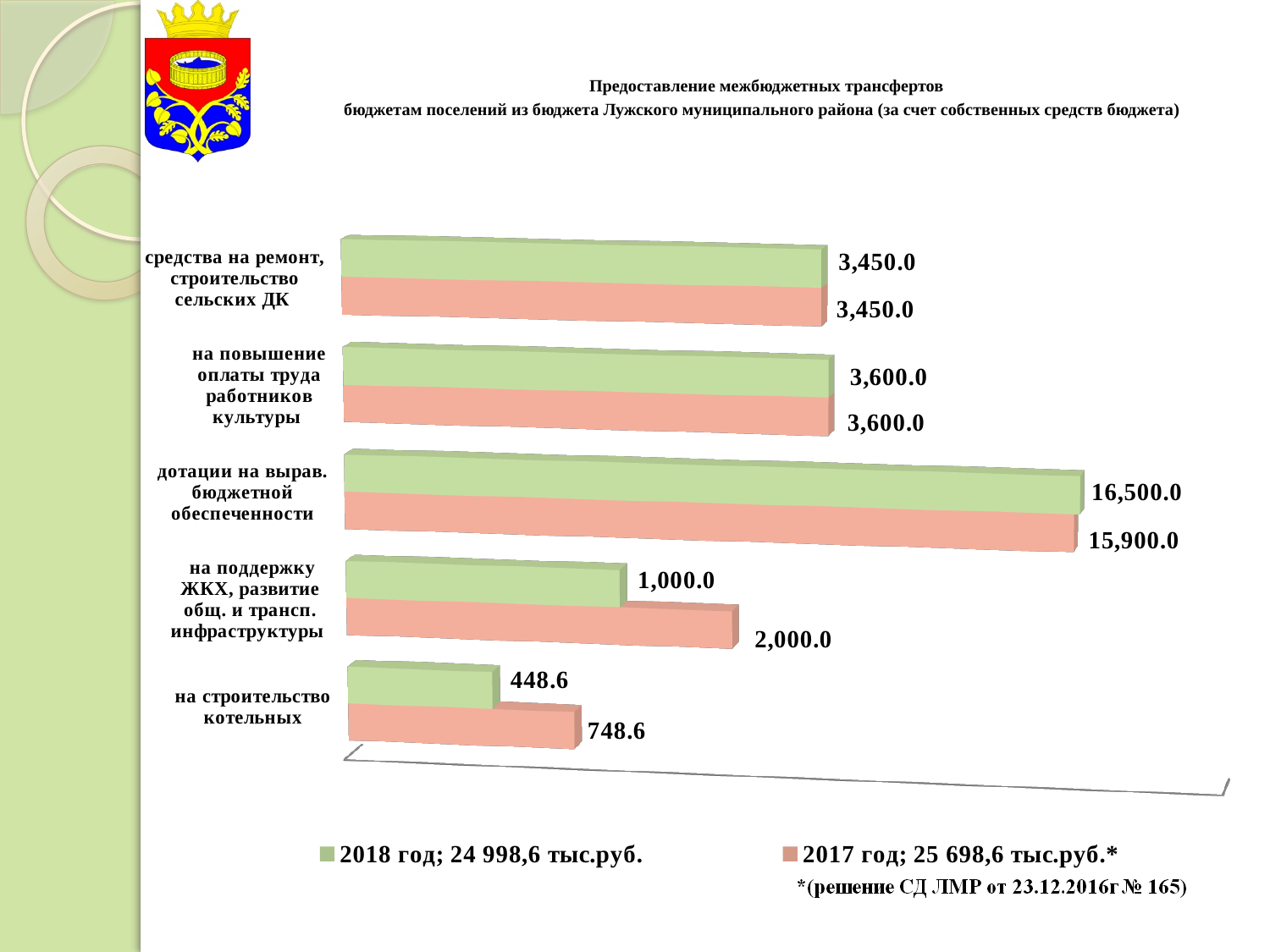
What is the 2018 год value for «на повышение оплаты труда работников культуры»? 3,600.0 Which category has the lowest 2017 год value? на строительство котельных What is the 2018 год value for «дотации на вырав. бюджетной обеспеченности»? 16,500.0 What kind of chart is shown on the slide? bar chart What is the 2017 год value for «на поддержку ЖКХ, развитие общ. и трансп. инфраструктуры»? 2,000.0 What is the difference between the 2017 год and 2018 год values for «на строительство котельных»? 300.0 Which category has the highest 2018 год value? дотации на вырав. бюджетной обеспеченности How many categories are shown in the chart? 5 For «на поддержку ЖКХ, развитие общ. и трансп. инфраструктуры», which year has the larger value, 2018 год or 2017 год? 2017 год What is the difference between the 2018 год and 2017 год values for «дотации на вырав. бюджетной обеспеченности»? 600.0 How many series does the legend list? 2 What is the 2017 год value for «на строительство котельных»? 748.6